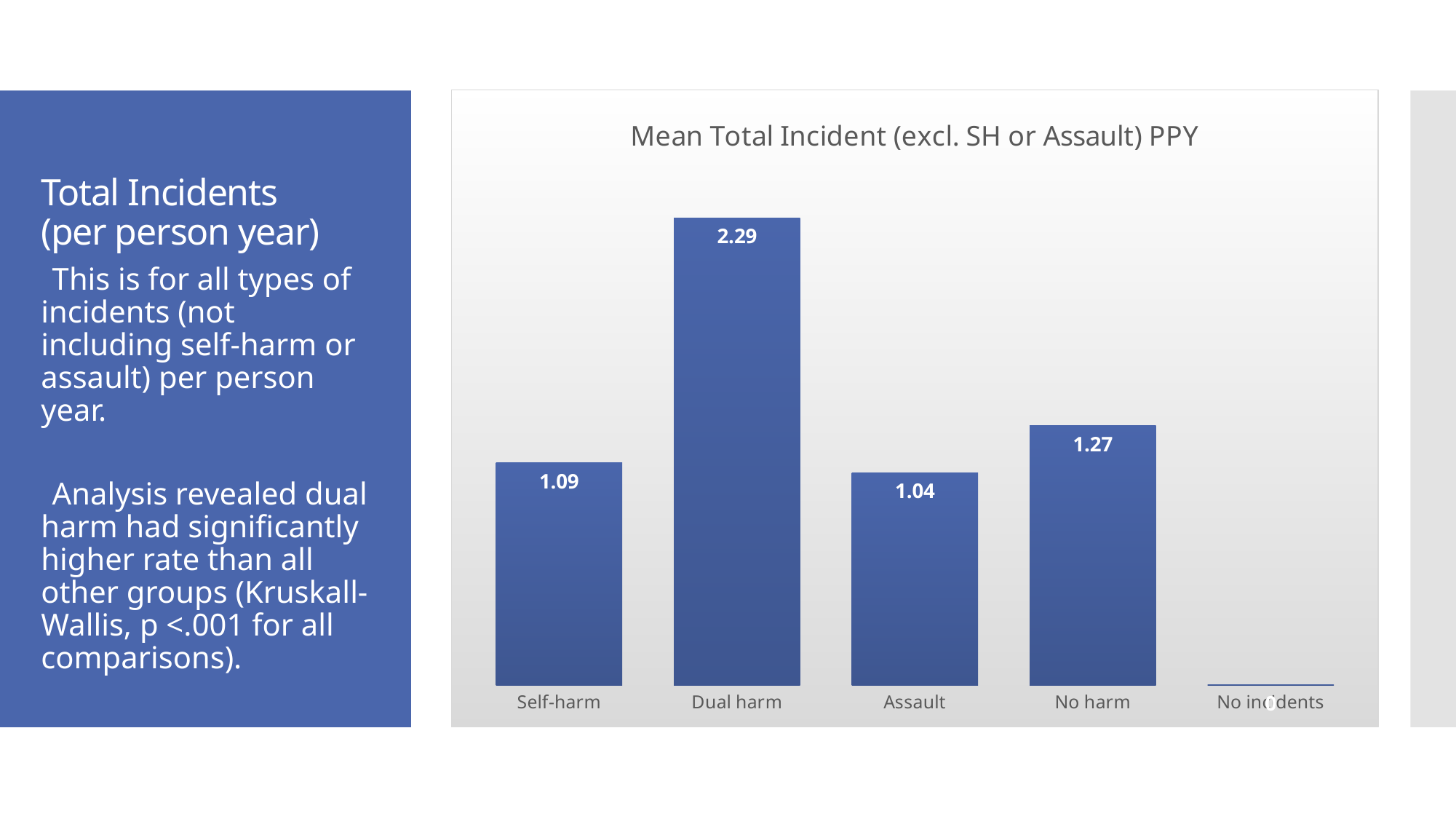
What is the value for Assault? 1.04 What is the value for Dual harm? 2.29 What is the title of the chart? Mean Total Incident (excl. SH or Assault) PPY How many categories are shown on the x axis? 5 What is the value for No harm? 1.27 Which category has the lowest value? No incidents Which is larger, the value for No harm or the value for Self-harm? No harm What is the difference between the values for Dual harm and Self-harm? 1.20 What kind of chart is shown on the slide? Bar chart What is the difference between the values for No harm and Assault? 0.23 What is the value for Self-harm? 1.09 Which category has the highest value? Dual harm